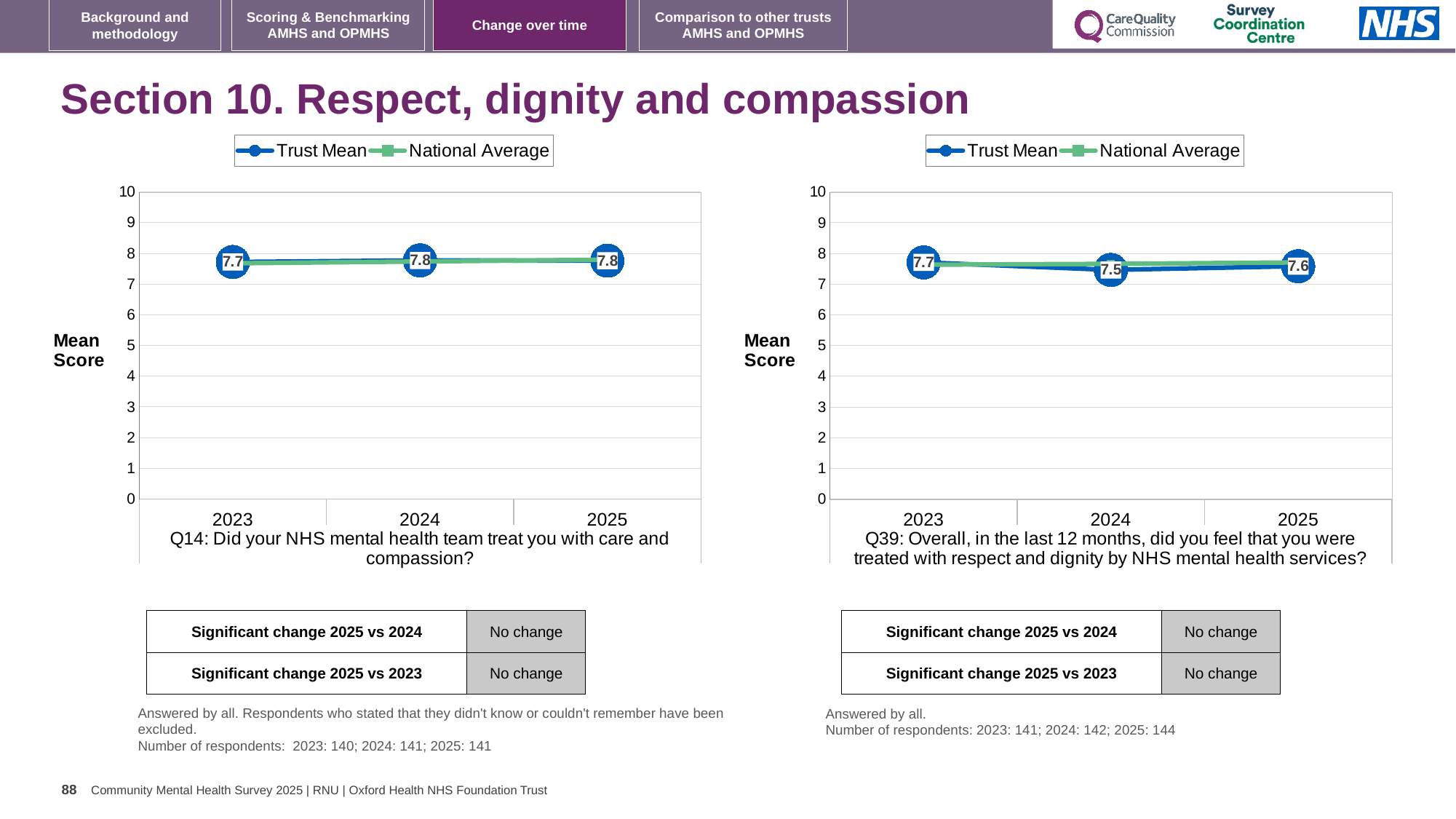
On the Q39 chart (right), what is the Trust Mean for 2024? 7.5 On the Q14 chart (left), is the Trust Mean for 2024 higher or lower than for 2023? higher On the Q14 chart (left), what is the Trust Mean for 2023? 7.7 On the Q39 chart (right), which year has the highest Trust Mean? 2023 How many series does the legend of the Q14 chart (left) list? 2 On the Q39 chart (right), what is the Trust Mean for 2025? 7.6 On the Q39 chart (right), what is the difference between the Trust Mean for 2023 and 2024? 0.2 What type of chart is the Q39 chart (right)? line chart On the Q14 chart (left), is the National Average for 2025 greater or less than 7? greater On the Q39 chart (right), which year has the lowest Trust Mean? 2024 On the Q14 chart (left), what is the Trust Mean for 2025? 7.8 How many years are shown on the x axis of the Q39 chart (right)? 3